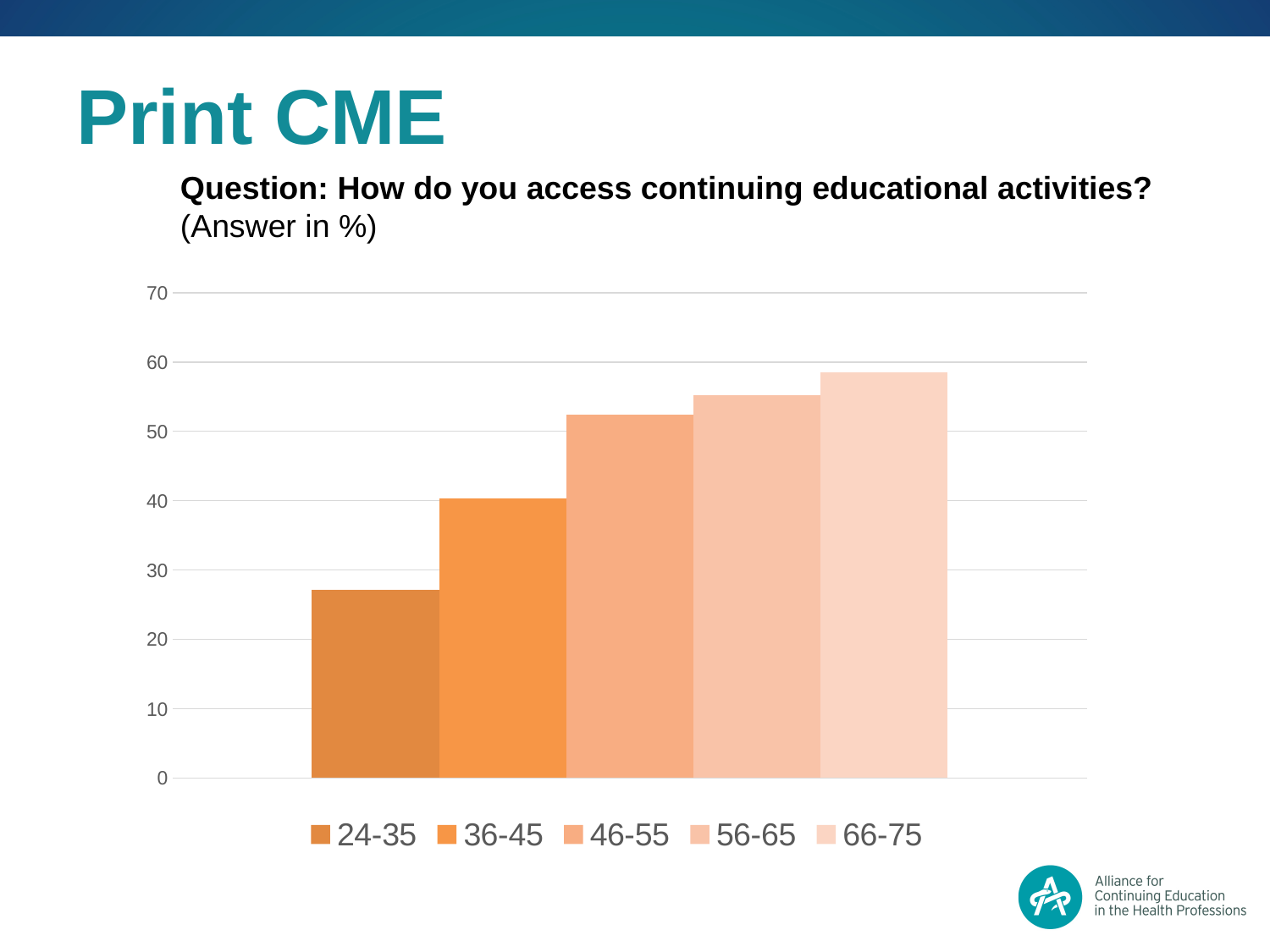
Do the values rise or fall as the age groups go from 24-35 to 66-75? rise Is the value for 46-55 greater or less than 50? greater Which is larger, the value for 36-45 or the value for 24-35? 36-45 How many entries does the legend list? 5 How many bars are plotted in the chart? 5 What kind of chart is shown on the slide? bar chart What is the highest value shown on the vertical axis? 70 Is the value for 36-45 greater or less than 50? less Is the value for 66-75 greater or less than 60? less Which age group has the lowest value? 24-35 Which age group has the highest value? 66-75